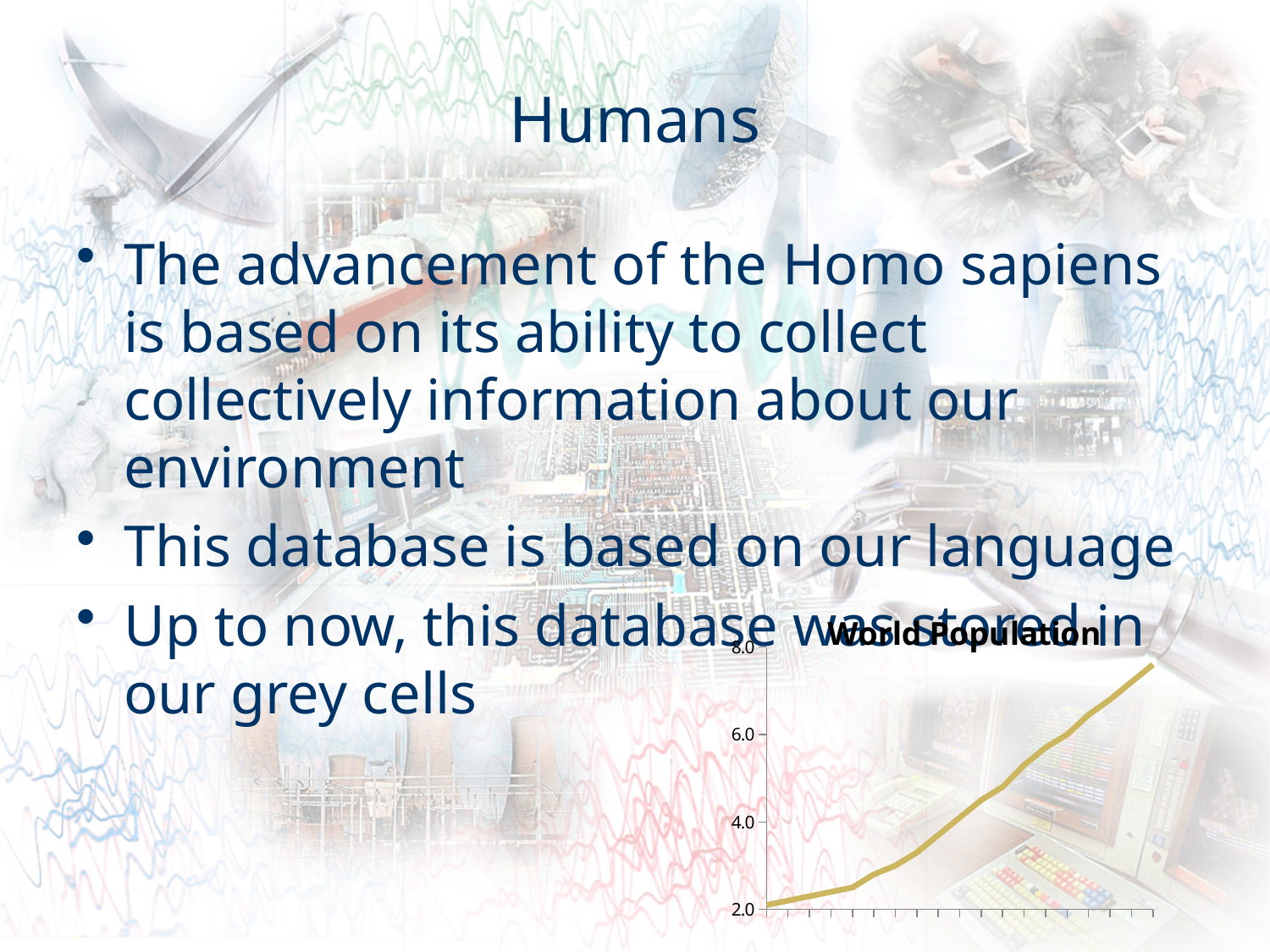
Do the values in the World Population chart rise or fall along the x axis? rise What kind of chart is shown on the slide? line chart In the World Population chart, is the value at the right end of the line greater or less than 8.0? less In the World Population chart, is the value at the left end of the line greater or less than 4.0? less What is the title of the chart on the slide? World Population What is the highest tick value shown on the y axis of the World Population chart? 8.0 In the World Population chart, is the value at the right end of the line greater or less than 6.0? greater